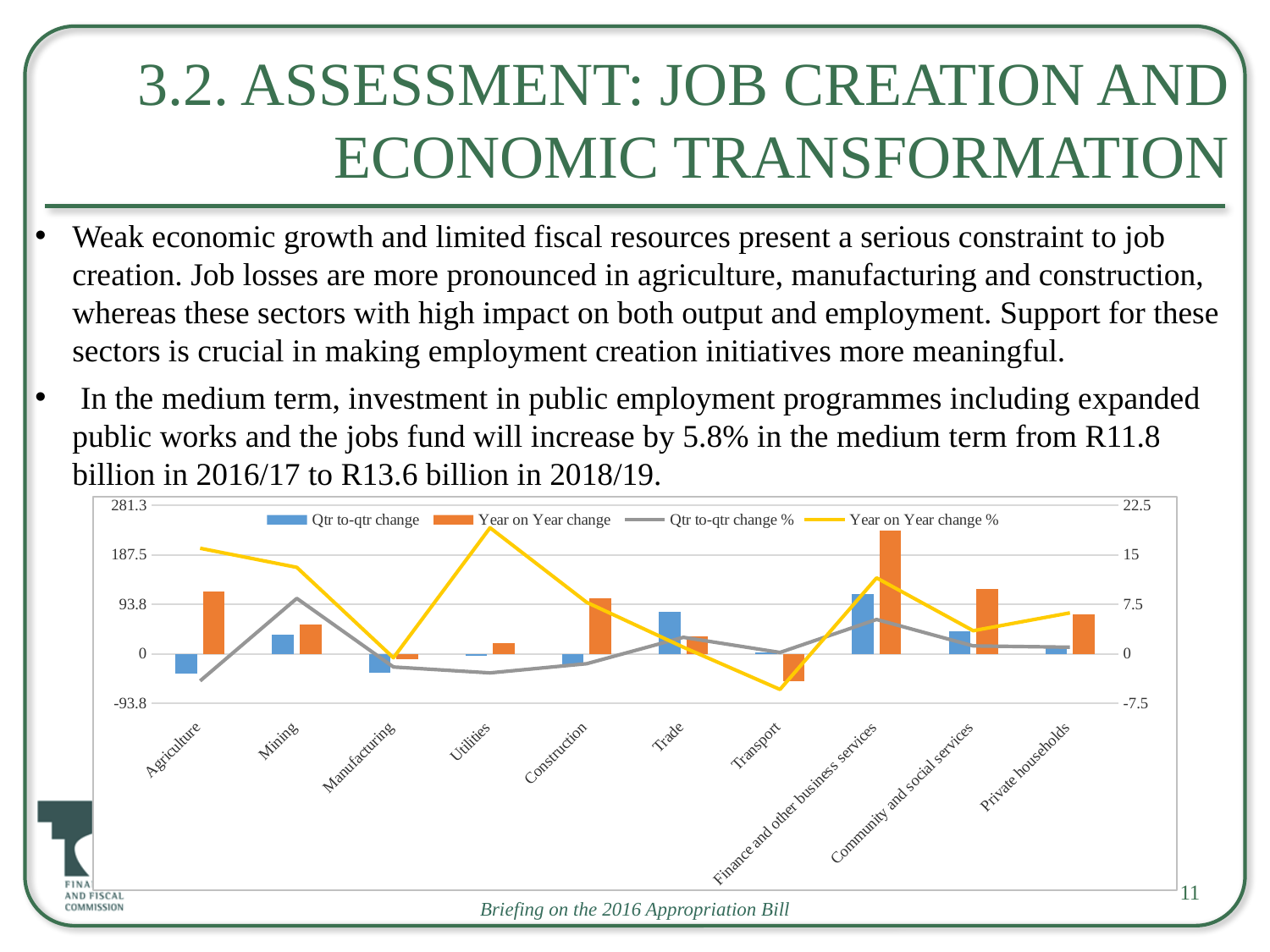
Which category has the highest point on the Year on Year change % line? Utilities Which is larger, the Year on Year change for Agriculture or for Mining? Agriculture Is the Year on Year change value for Finance and other business services greater or less than 187.3? greater Which series in the legend is drawn as a yellow line? Year on Year change % How many categories are shown on the x axis of the chart? 10 Which category has the highest Year on Year change bar? Finance and other business services Is the Year on Year change value for Agriculture greater or less than 93.8? greater Which category has the lowest Year on Year change bar? Transport What kind of chart is shown on the slide? A combined bar and line chart How many series does the chart's legend list? 4 Is the Qtr to-qtr change value for Agriculture greater or less than 0? less Which category has the highest Qtr to-qtr change bar? Finance and other business services